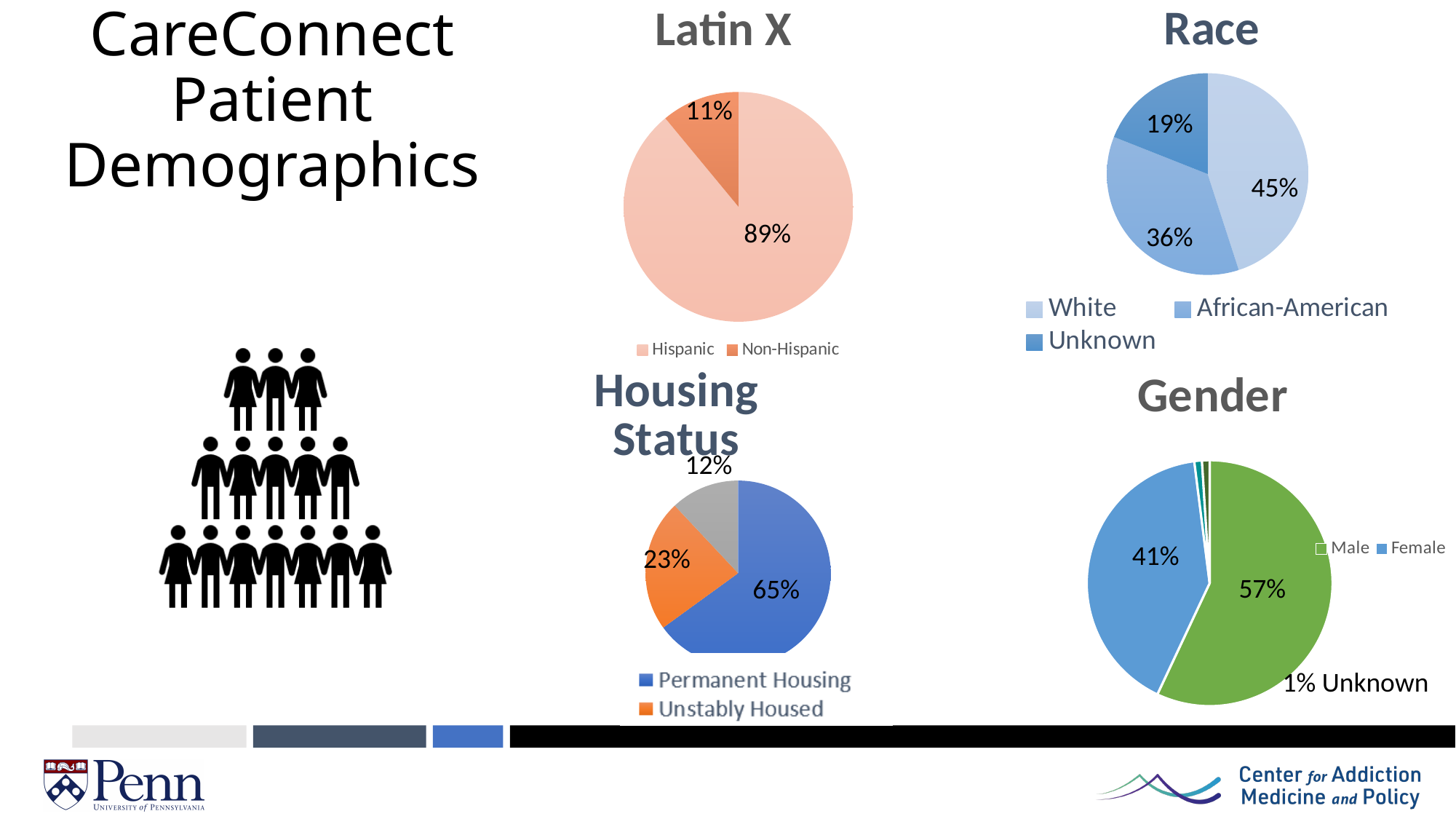
In the Housing Status chart, what percentage of patients are Unstably Housed? 23% In the Race chart, what percentage of patients are African-American? 36% What type of chart is used for the Race data? Pie chart In the Race chart, what percentage of patients are White? 45% In the Gender chart, what percentage of patients are Female? 41% In the Latin X chart, what percentage of patients are Hispanic? 89% In the Latin X chart, what percentage of patients are Non-Hispanic? 11% In the Housing Status chart, how many slices does the pie have? 3 In the Gender chart, what percentage of patients have Unknown gender? 1% In the Housing Status chart, what percentage of patients are in Permanent Housing? 65% In the Race chart, what is the difference between the White and African-American shares? 9% In the Race chart, which category has the smallest share? Unknown